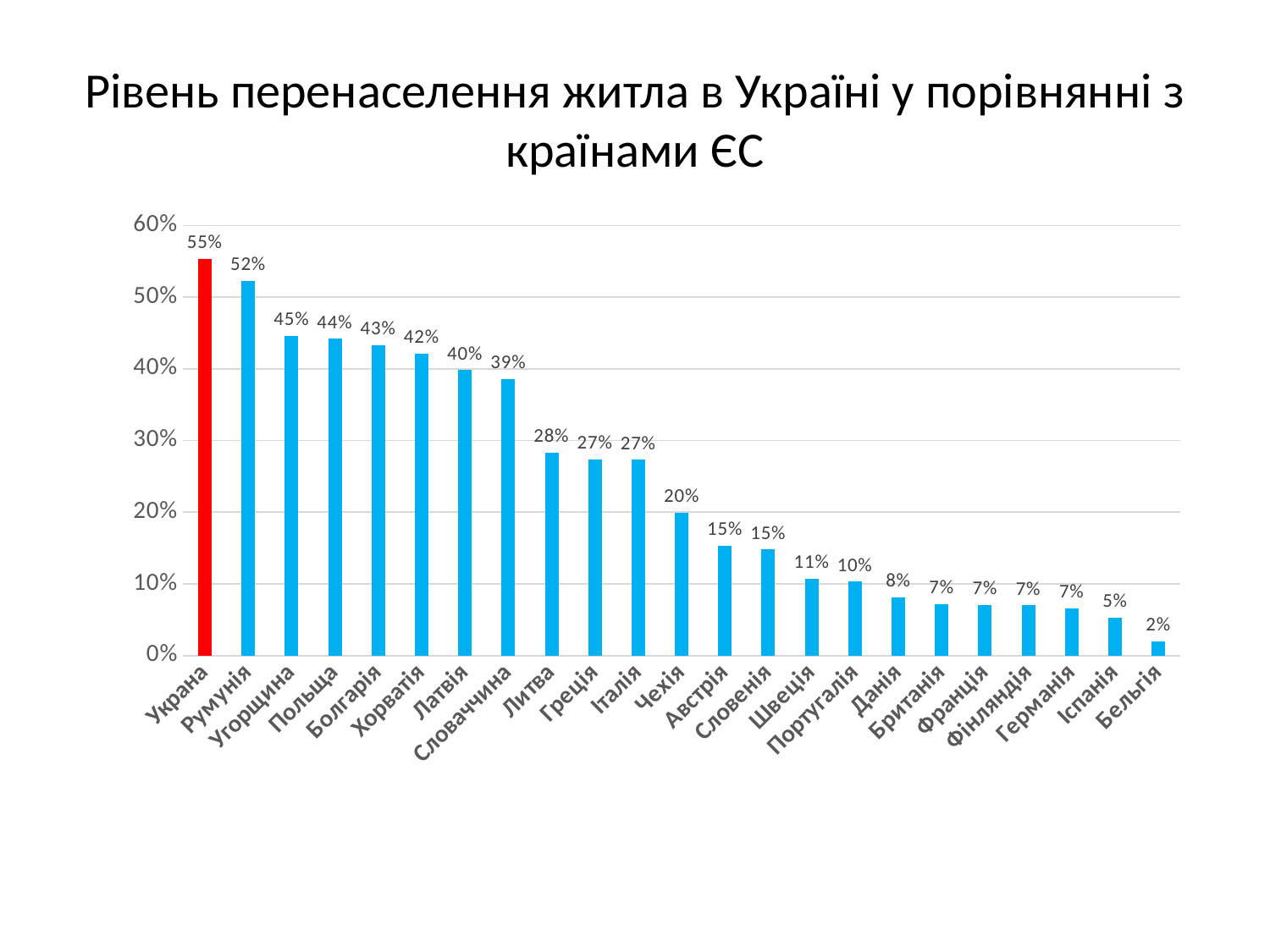
What is the difference between the values for Украна and Румунія? 3% What type of chart is shown on the slide? bar chart Which country has the lowest value in the chart? Бельгія Which country has the highest value in the chart? Украна How many countries are shown in the chart? 23 What is the value for Португалія? 10% What is the value for Румунія? 52% Which bar is coloured red rather than blue? Украна What is the difference between the values for Чехія and Іспанія? 15% Which has a larger value, Угорщина or Словаччина? Угорщина Do the values rise or fall from left to right along the x axis? fall What is the value for Литва? 28%